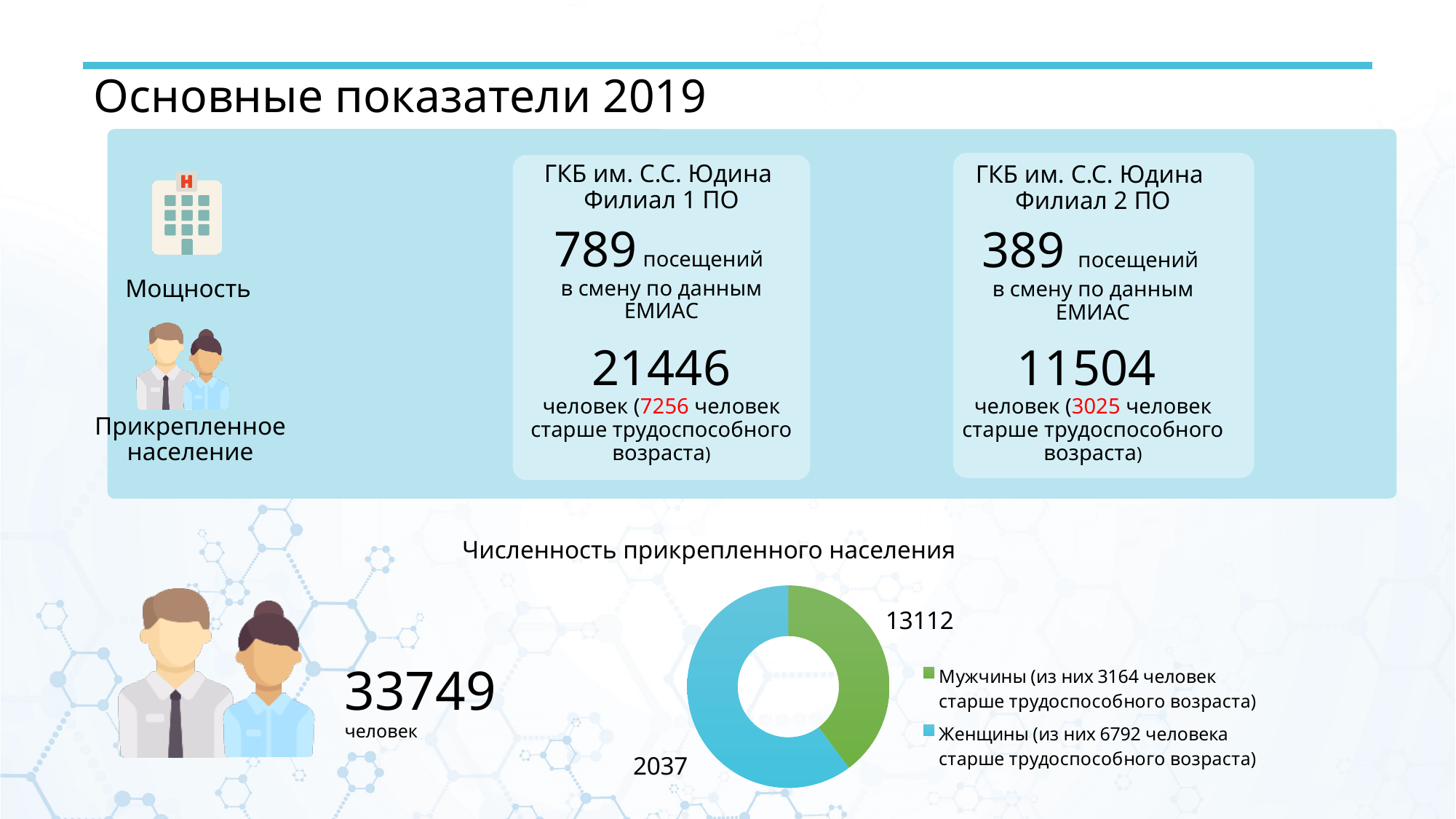
How many slices does the doughnut chart have? 2 How many entries does the legend of the doughnut chart list? 2 According to the legend, how many of the Мужчины are older than working age? 3164 What is the title of the chart on the slide? Численность прикрепленного населения According to the legend, how many of the Женщины are older than working age? 6792 Which colour represents Женщины in the doughnut chart? Blue What value is labelled on the Мужчины slice of the doughnut chart? 13112 What kind of chart is shown under the title "Численность прикрепленного населения"? Doughnut (pie) chart